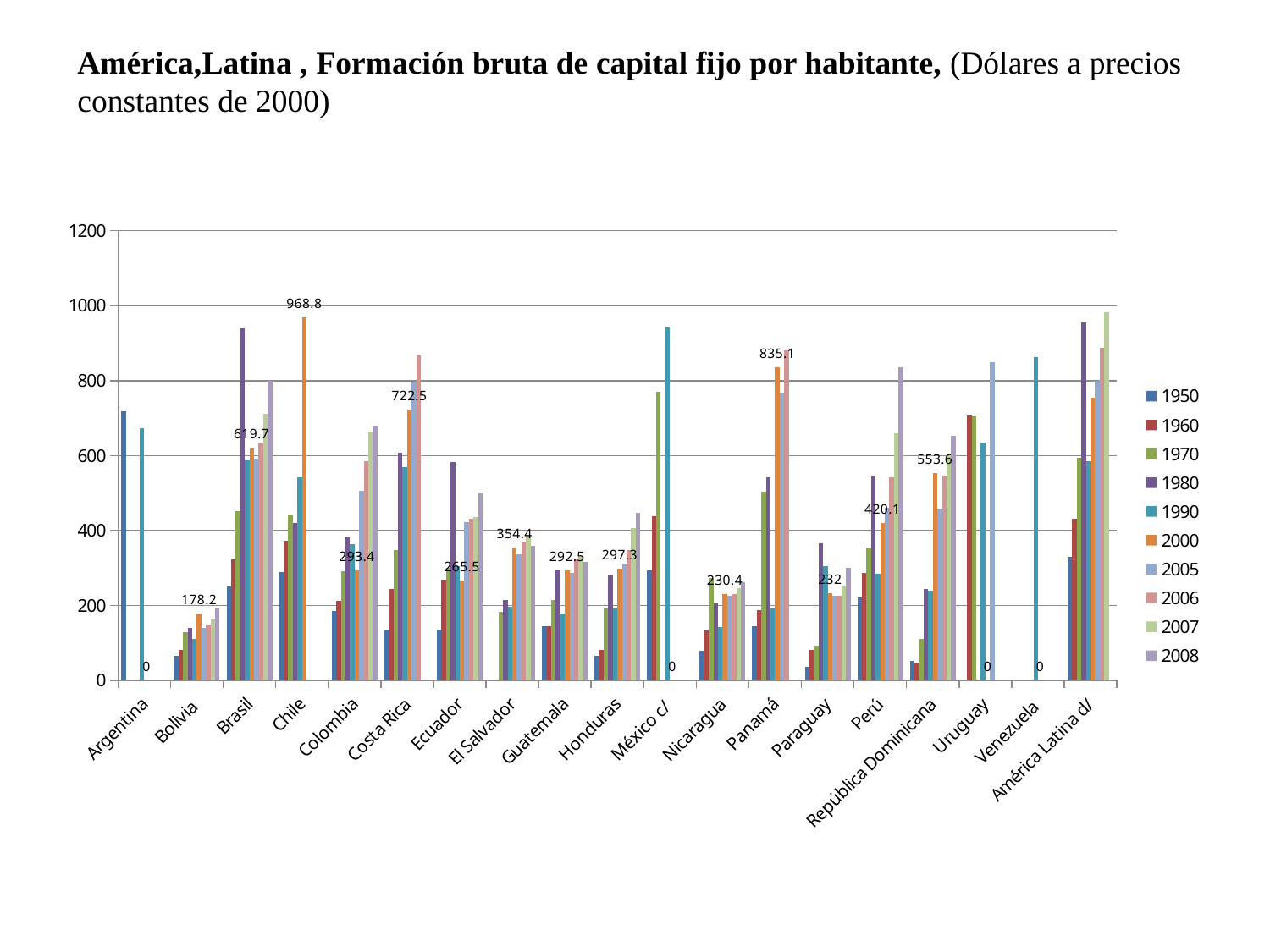
Which is larger, the 2000 value for Perú or the 2000 value for El Salvador? Perú What is the difference between the 2000 values for Chile and Panamá? 133.7 Is the 1950 value for Argentina greater or less than 600? greater Which country has the highest labelled value for the 2000 series? Chile What is the 2000 value for Bolivia? 178.2 What is the 2000 value for Chile? 968.8 What is the difference between the 2000 values for Costa Rica and Brasil? 102.8 How many series does the legend list? 10 How many categories are shown on the x axis? 19 Is the 1990 value for Venezuela greater or less than 600? greater What is the 2000 value for Panamá? 835.1 What is the 2000 value for Paraguay? 232